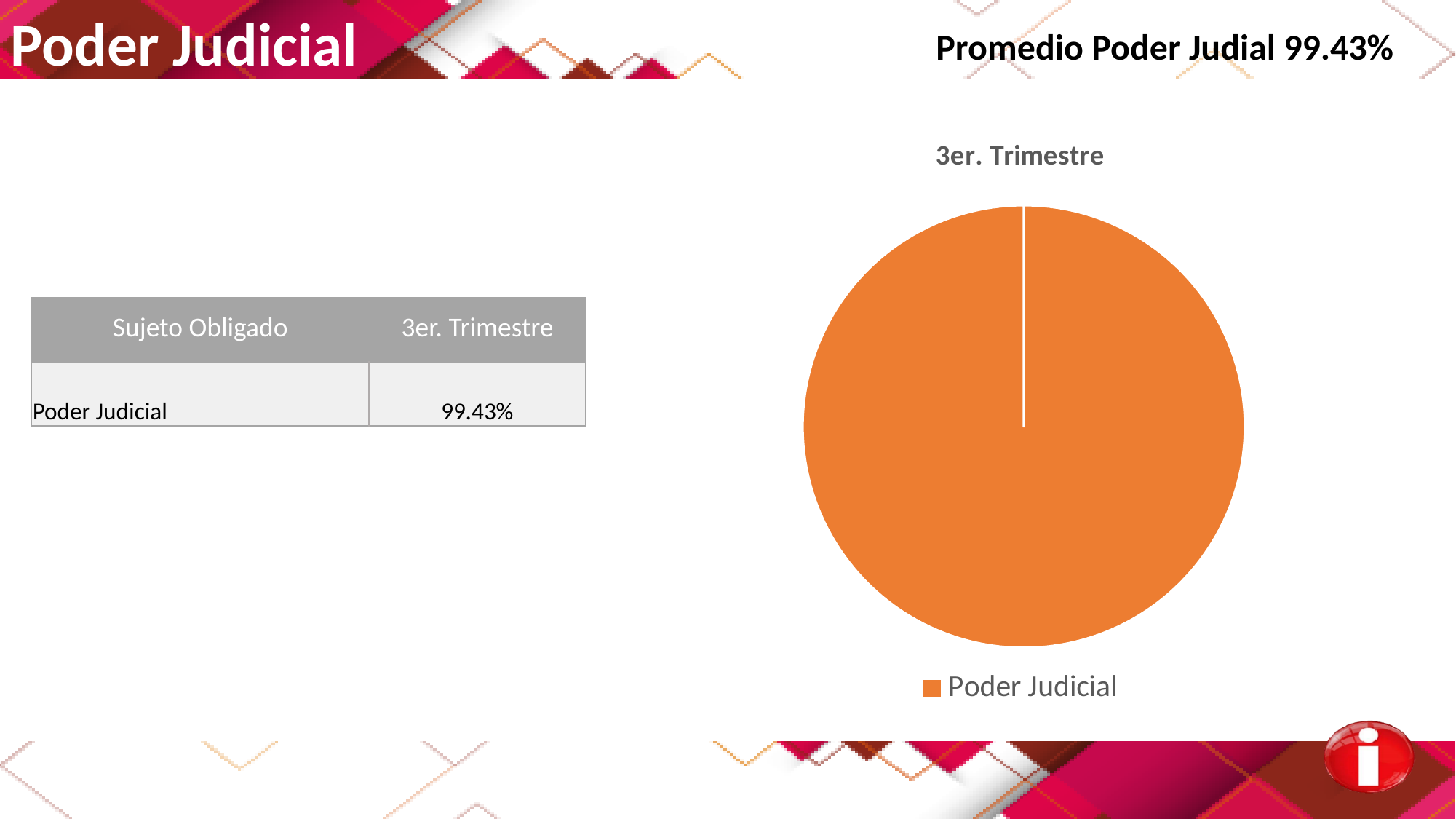
What is the 3er. Trimestre value for Poder Judicial printed on the slide? 99.43% How many entries does the legend of the pie chart list? 1 What share of the pie does the Poder Judicial slice take up? 100% How many slices does the pie chart have? 1 What is the title of the pie chart? 3er. Trimestre What kind of chart is shown on the slide? pie chart What is the only category shown in the pie chart's legend? Poder Judicial